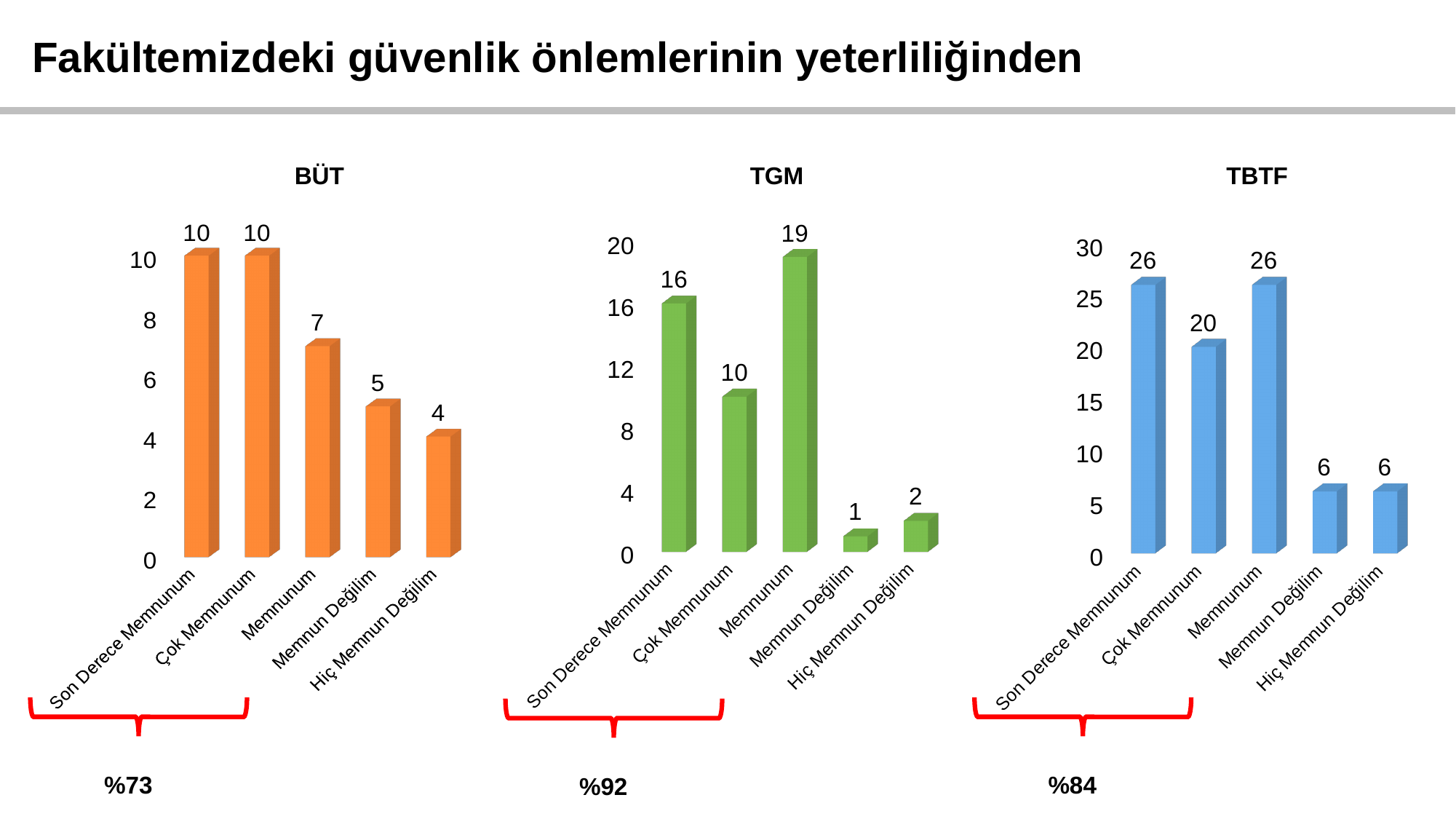
In the TBTF chart, what is the value for Çok Memnunum? 20 In the TGM chart, which category has the highest value? Memnunum In the TGM chart, what is the value for Çok Memnunum? 10 In the TBTF chart, what is the difference between the values for Son Derece Memnunum and Çok Memnunum? 6 What colour are the bars in the TBTF chart? blue In the BÜT chart, which is larger, the value for Memnun Değilim or the value for Hiç Memnun Değilim? Memnun Değilim In the TGM chart, what is the difference between the values for Memnunum and Son Derece Memnunum? 3 What kind of chart is the TGM chart? bar chart How many categories does the TBTF chart show? 5 In the BÜT chart, which category has the lowest value? Hiç Memnun Değilim In the BÜT chart, what is the value for Memnunum? 7 In the TGM chart, which category has the lowest value? Memnun Değilim